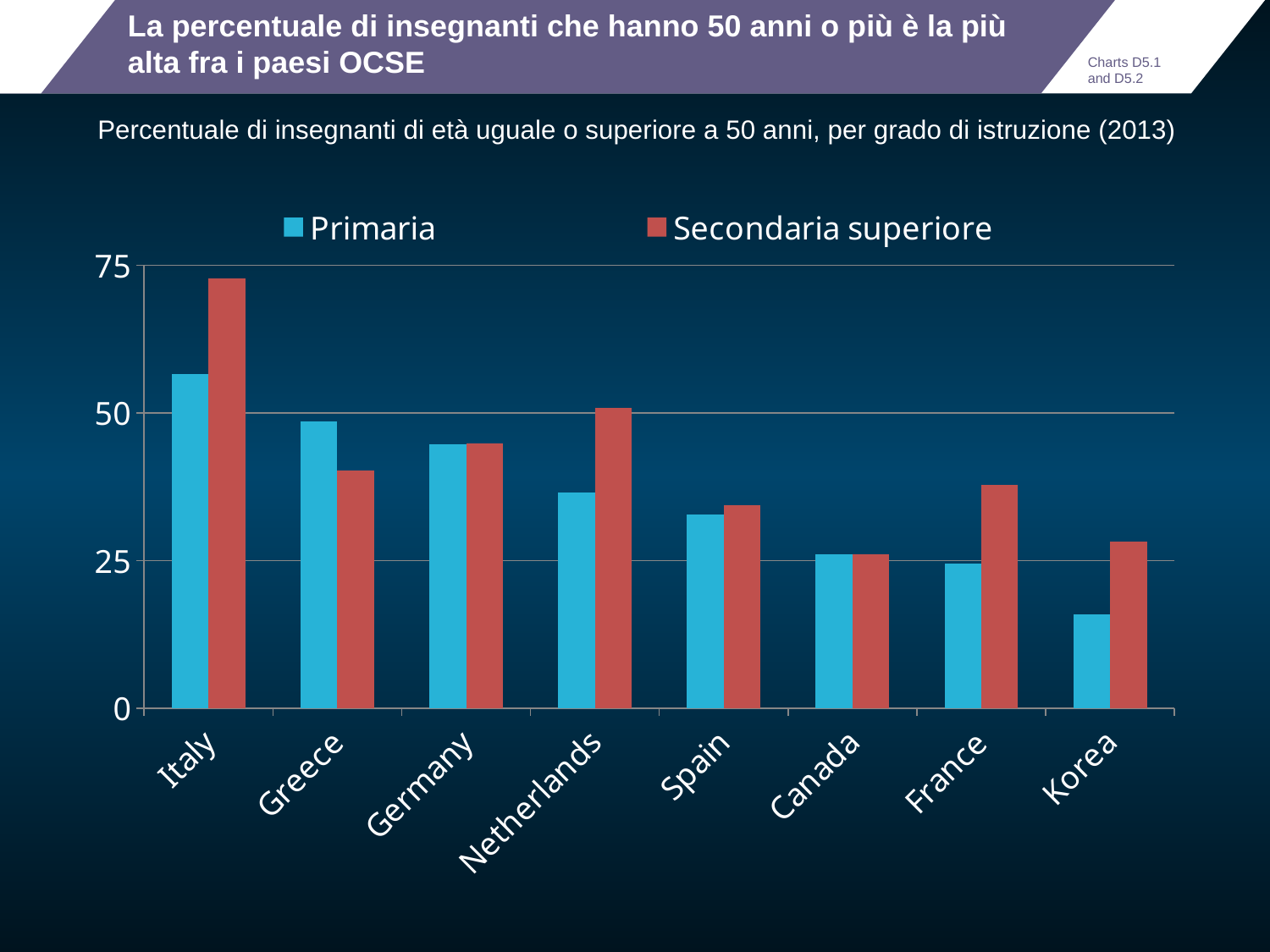
Which country has the highest value for Secondaria superiore? Italy Do the Primaria values rise or fall moving from Italy to Korea along the x axis? fall For Greece, which is larger: the Primaria value or the Secondaria superiore value? Primaria What kind of chart is shown on the slide? Bar chart How many series does the chart's legend list? 2 Is the Secondaria superiore value for France greater or less than 25? greater Which country has the highest value for Primaria? Italy Is the Primaria value for Korea greater or less than 25? less For Netherlands, which is larger: the Primaria value or the Secondaria superiore value? Secondaria superiore How many countries are shown on the x axis of the chart? 8 Is the Secondaria superiore value for Italy greater or less than 50? greater Which country has the lowest value for Primaria? Korea